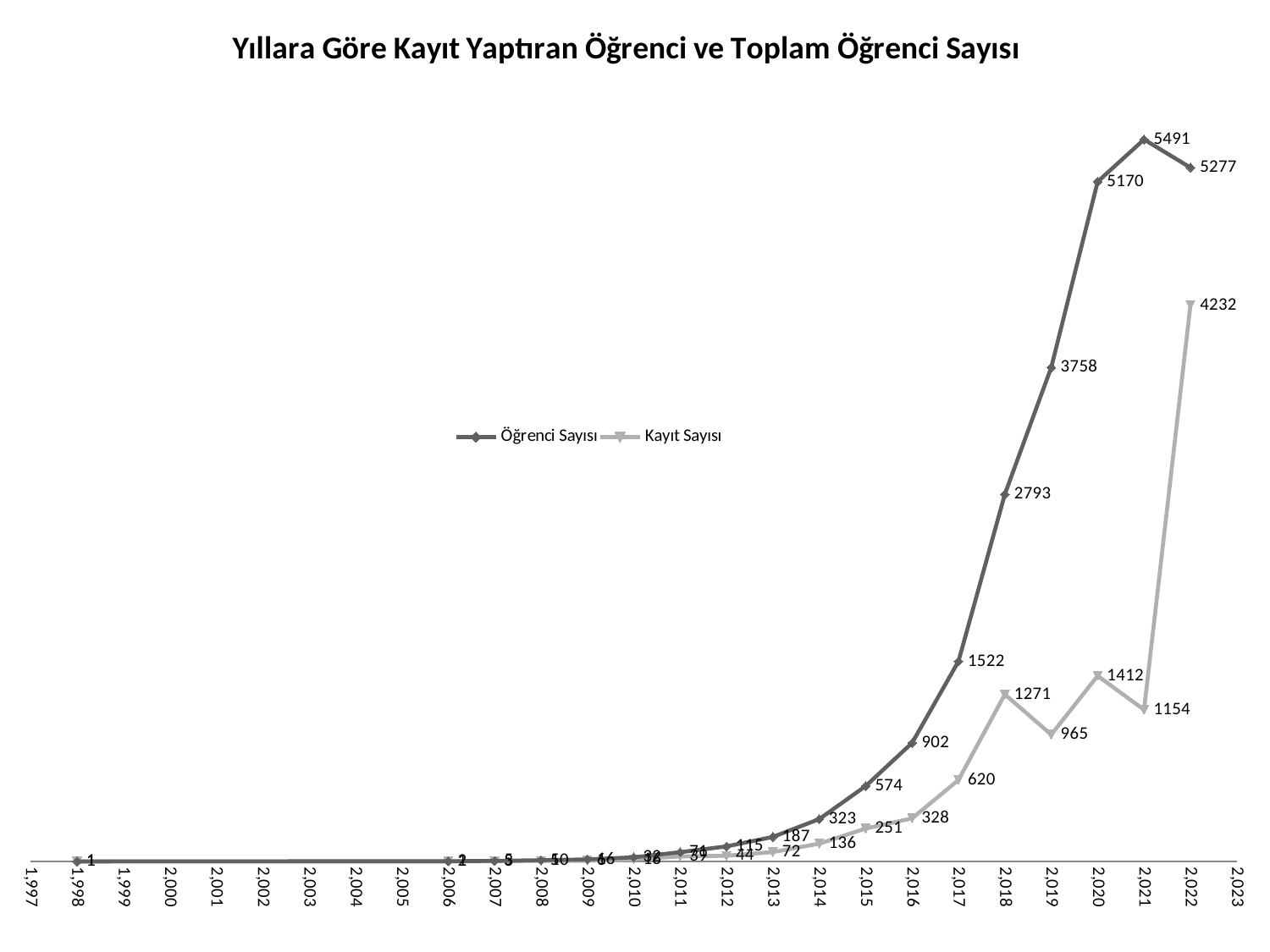
What is the Kayıt Sayısı value for 2022? 4232 Which year has the larger Kayıt Sayısı value, 2018 or 2019? 2018 What is the difference between the Kayıt Sayısı values for 2020 and 2019? 447 How many series does the legend list? 2 In which year is Öğrenci Sayısı highest? 2021 In which year is Kayıt Sayısı highest? 2022 What is the Öğrenci Sayısı value for 2017? 1522 What is the title of the chart? Yıllara Göre Kayıt Yaptıran Öğrenci ve Toplam Öğrenci Sayısı What is the difference between the Öğrenci Sayısı values for 2021 and 2022? 214 Does the Öğrenci Sayısı series rise or fall from 2013 to 2020? rise What is the Öğrenci Sayısı value for 2021? 5491 What kind of chart is shown on the slide? line chart